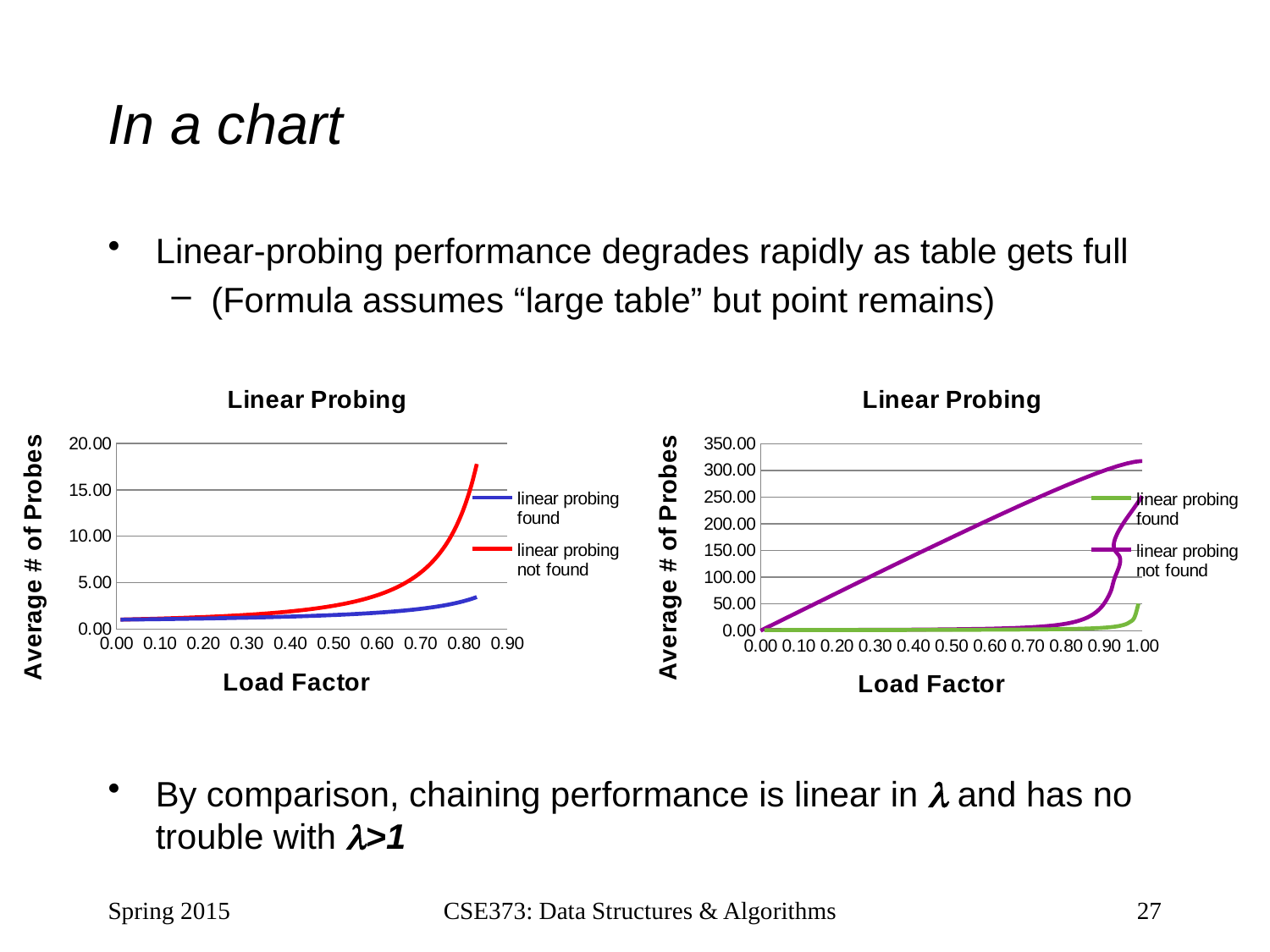
What is the title of the right chart? Linear Probing What is the y-axis label of the left chart? Average # of Probes In the left chart, is the value for 'linear probing not found' at load factor 0.50 greater or less than 5.00? less How many series does the legend of the left chart list? 2 What type of chart is the right chart on the slide? line chart What type of chart is the left chart on the slide? line chart In the left chart, at load factor 0.80, which series has the larger value: 'linear probing found' or 'linear probing not found'? linear probing not found In the right chart, is the value for 'linear probing found' at load factor 0.80 greater or less than 50.00? less In the right chart, at load factor 0.60, which series has the larger value: 'linear probing found' or 'linear probing not found'? linear probing not found In the left chart, is the value for 'linear probing found' at load factor 0.80 greater or less than 5.00? less In the left chart, does the 'linear probing not found' series rise or fall as the load factor increases? rise